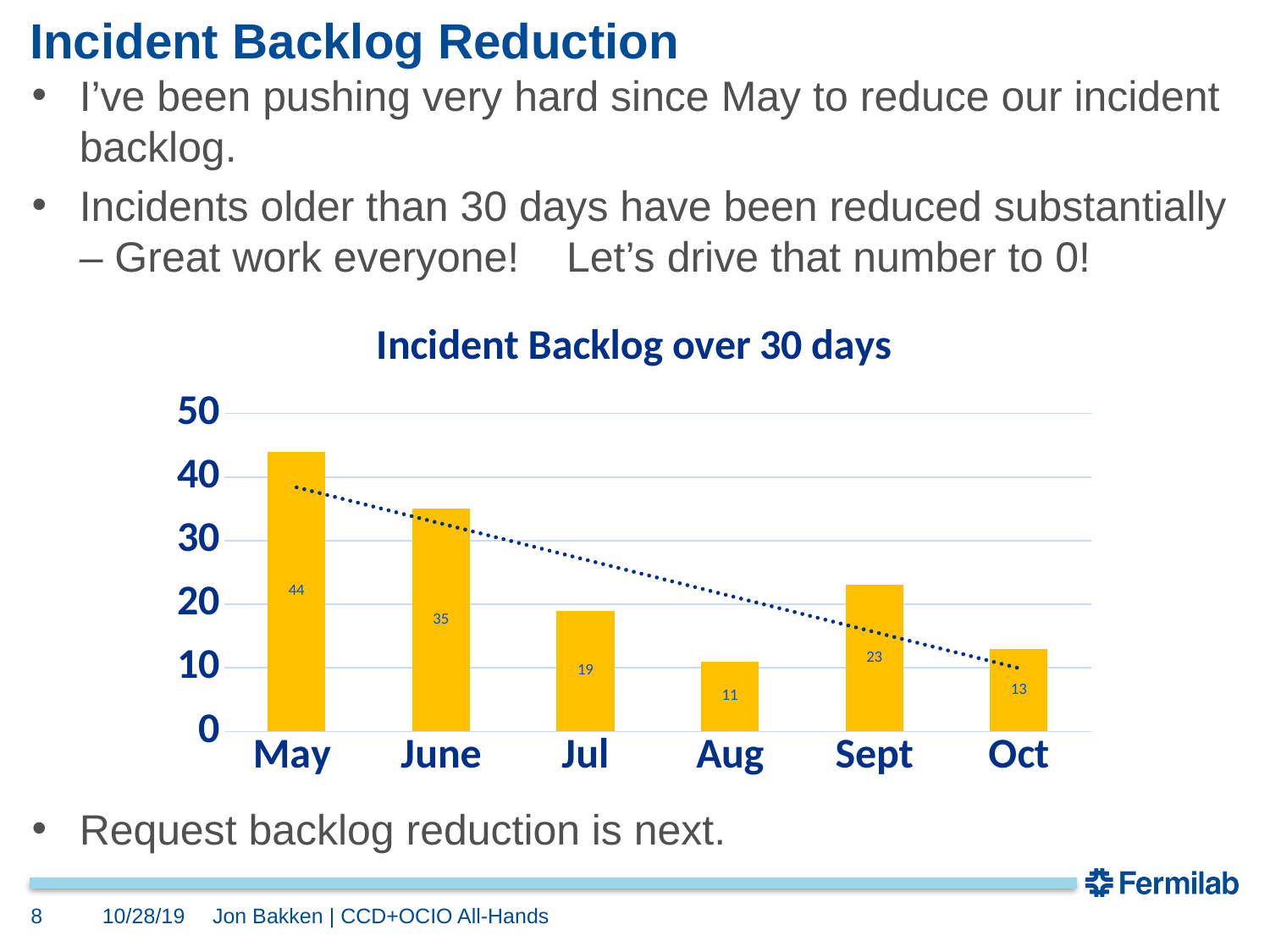
What is the difference between the May and June values in the chart? 9 What is the title of the chart on the slide? Incident Backlog over 30 days What kind of chart is shown on the slide? bar chart Is the value for June greater or less than 30? greater What is the difference between the Sept and Oct values in the chart? 10 What is the value for May in the Incident Backlog over 30 days chart? 44 What is the value for Sept in the Incident Backlog over 30 days chart? 23 Which is larger, the value for Jul or the value for Sept? Sept How many months are shown on the x axis of the chart? 6 What is the value for Aug in the Incident Backlog over 30 days chart? 11 Which month has the lowest incident backlog over 30 days? Aug Which month has the highest incident backlog over 30 days? May